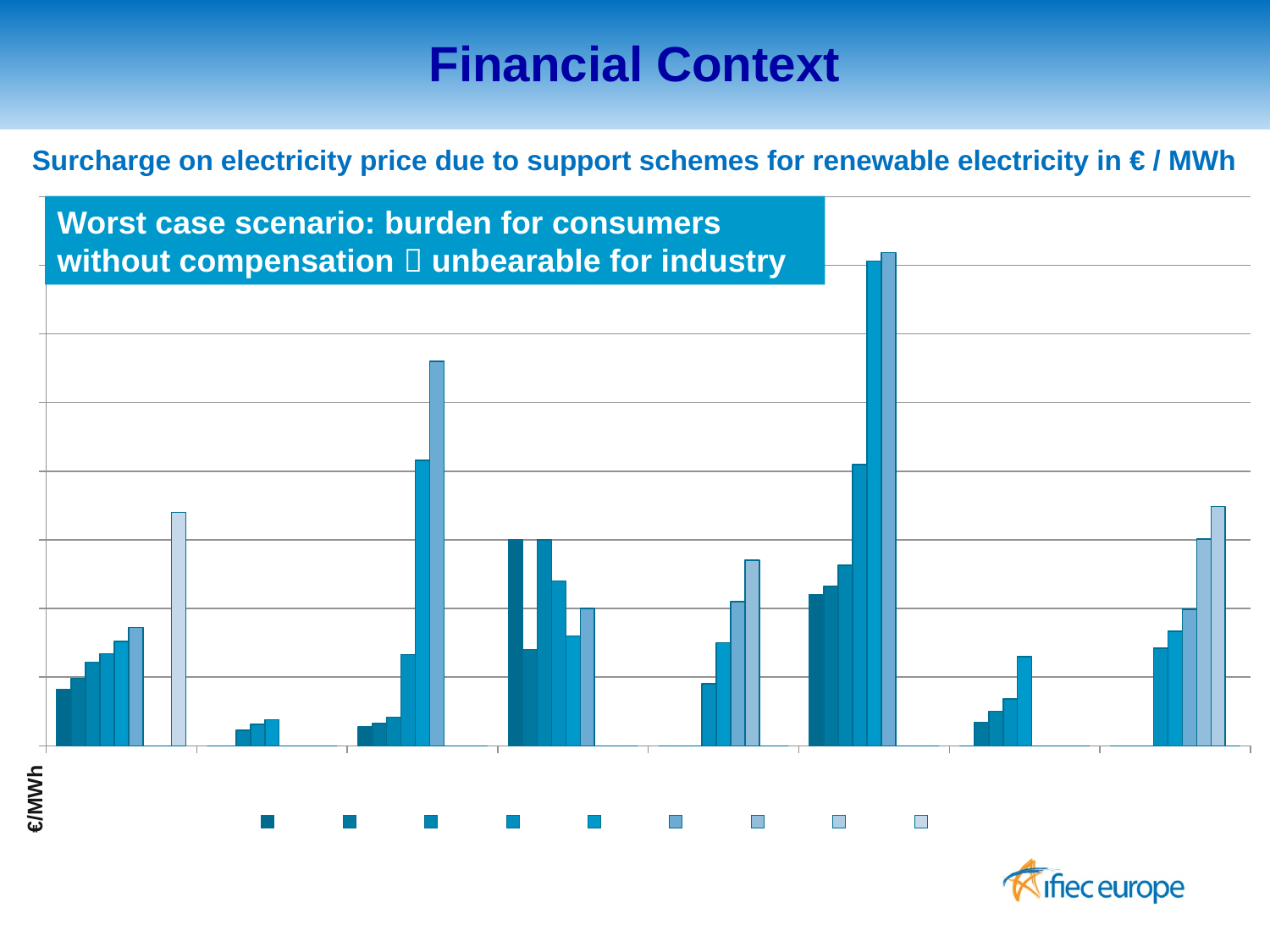
What is the label on the vertical axis of the chart? €/MWh What unit is the surcharge on electricity price expressed in, according to the chart heading? € / MWh How many category groups are marked along the x axis of the chart? 8 How many series does the legend below the chart list? 9 Counting from the left, which category group contains the tallest bar in the chart? the sixth group What kind of chart is shown on the slide? bar chart